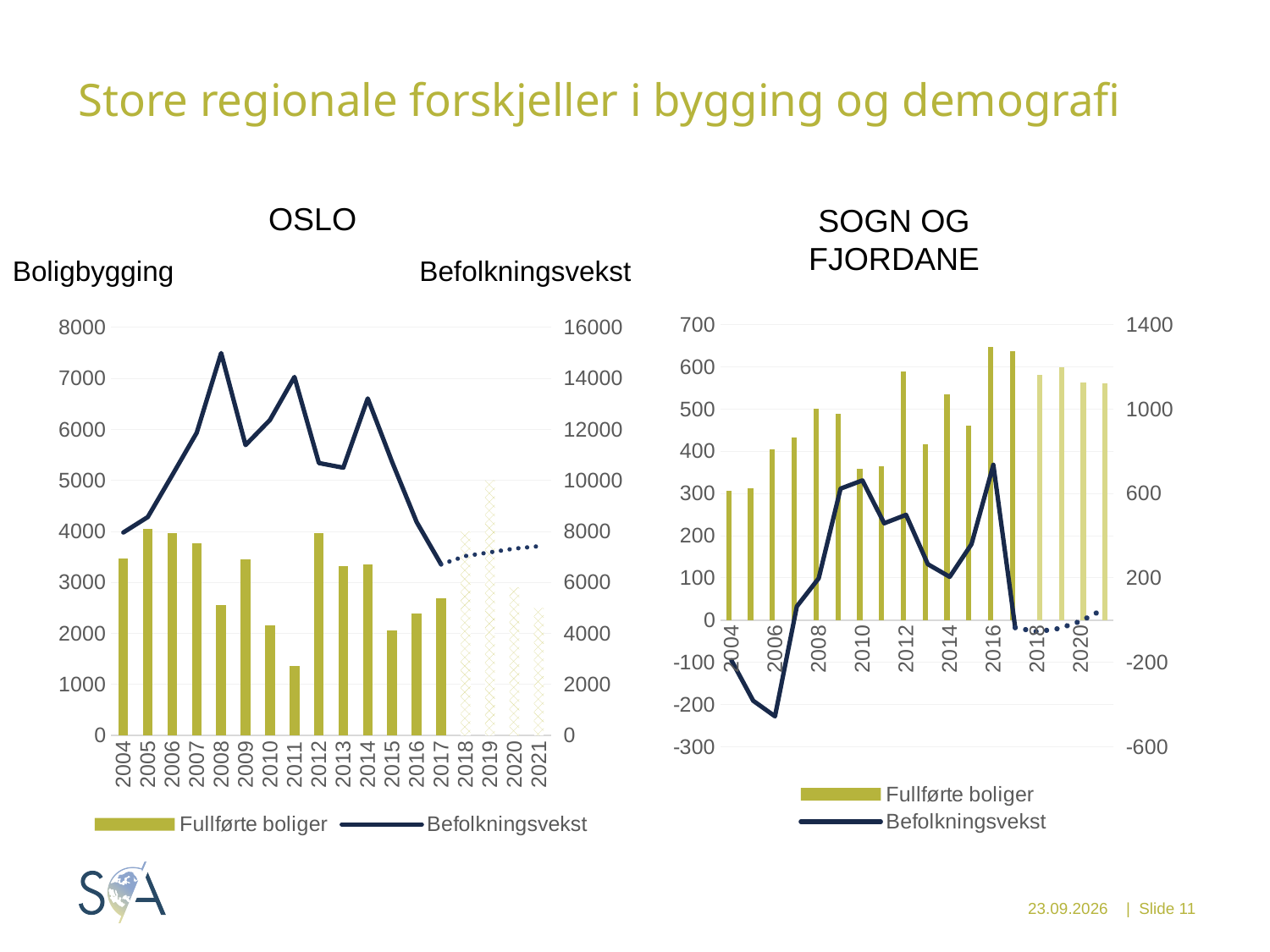
What are the two series named in the legend of the OSLO chart? Fullførte boliger and Befolkningsvekst In the OSLO chart, which year has the larger Fullførte boliger bar, 2011 or 2012? 2012 In the OSLO chart, does the Befolkningsvekst line rise or fall from 2014 to 2017? fall In the SOGN OG FJORDANE chart, is the Fullførte boliger value for 2011 greater or less than 400? less In the OSLO chart, how many years are shown on the x axis? 18 In the OSLO chart, in which year does the Befolkningsvekst line reach its highest point? 2008 What kind of chart is the OSLO chart? Combined bar and line chart In the OSLO chart, is the Fullførte boliger value for 2011 greater or less than 2000? less In the OSLO chart, is the Befolkningsvekst value for 2008 greater or less than 14000? greater In the SOGN OG FJORDANE chart, in which year does the Befolkningsvekst line reach its lowest point? 2006 How many series does the legend of the SOGN OG FJORDANE chart list? 2 In the OSLO chart, which year has the lowest Fullførte boliger bar? 2011